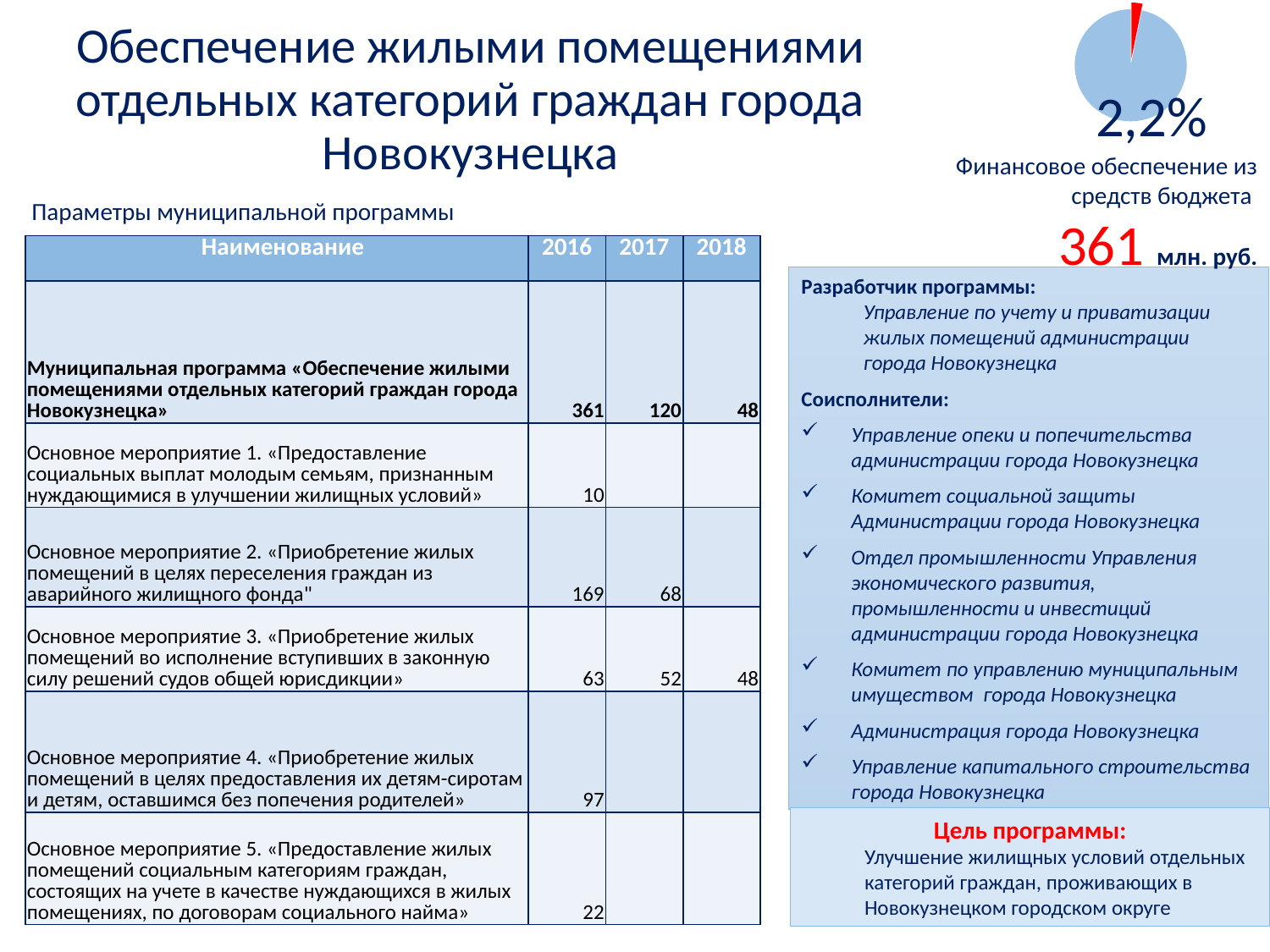
What caption is written under the pie chart in the top right? Финансовое обеспечение из средств бюджета Is the share shown by the red slice of the pie chart greater or less than 50%? less What kind of chart is shown in the top right corner of the slide? pie chart What share of the pie chart does the highlighted (red) slice represent? 2,2% How many slices does the pie chart in the top right have? 2 What colour is the small slice of the pie chart? red